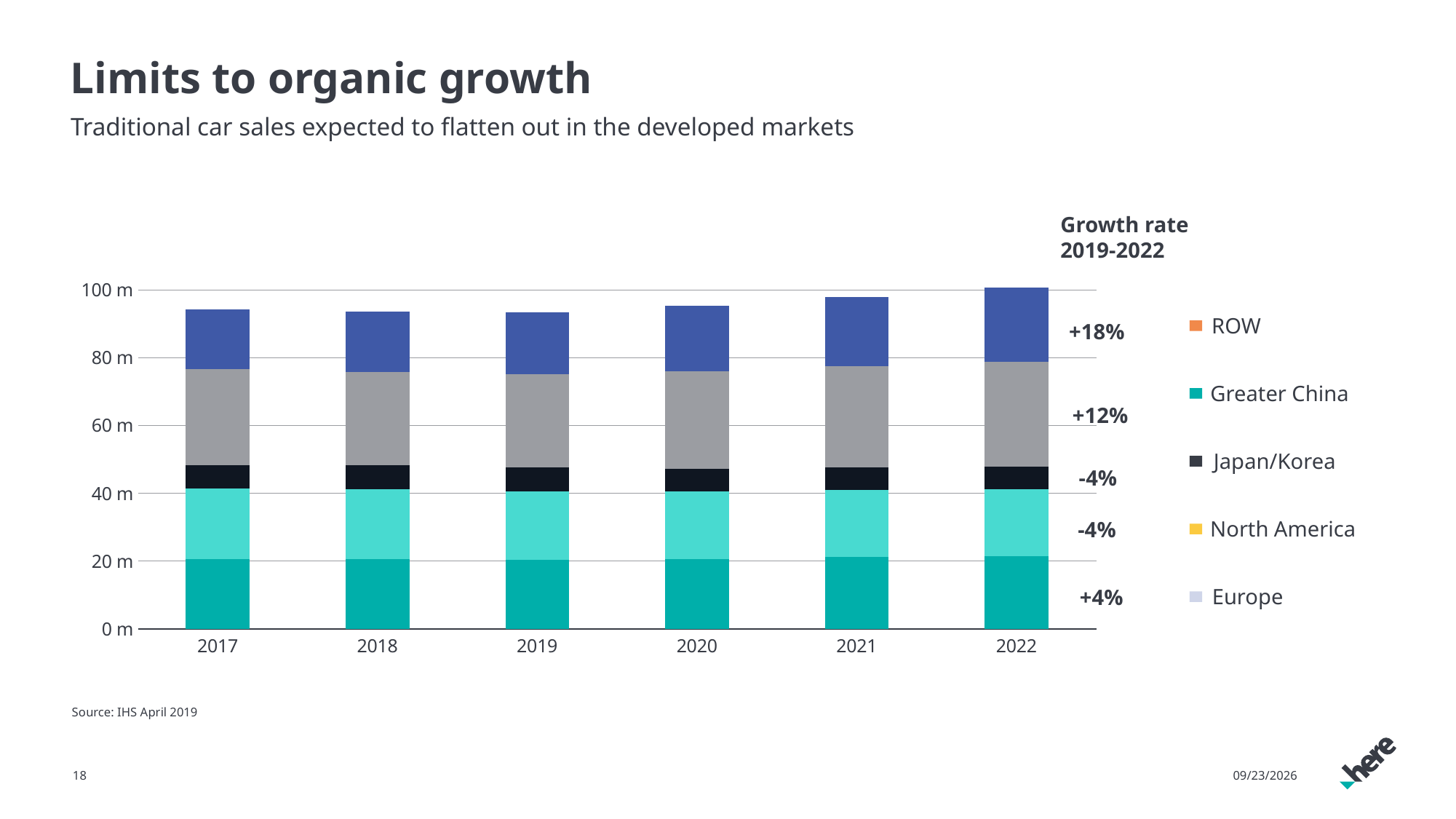
Is the total for 2017 greater or less than 100 m? less What kind of chart is shown on the slide? bar chart What is the first entry listed in the chart legend? ROW How many years are shown on the x axis of the chart? 6 Which year has the highest total stacked bar? 2022 How many series does the chart legend list? 5 What is the highest growth rate for 2019-2022 shown next to the chart? +18% Is the total for 2017 greater or less than 80 m? greater Is the total for 2019 greater or less than 100 m? less Which total is larger, 2017 or 2022? 2022 Do the total bar heights rise or fall from 2019 to 2022? rise